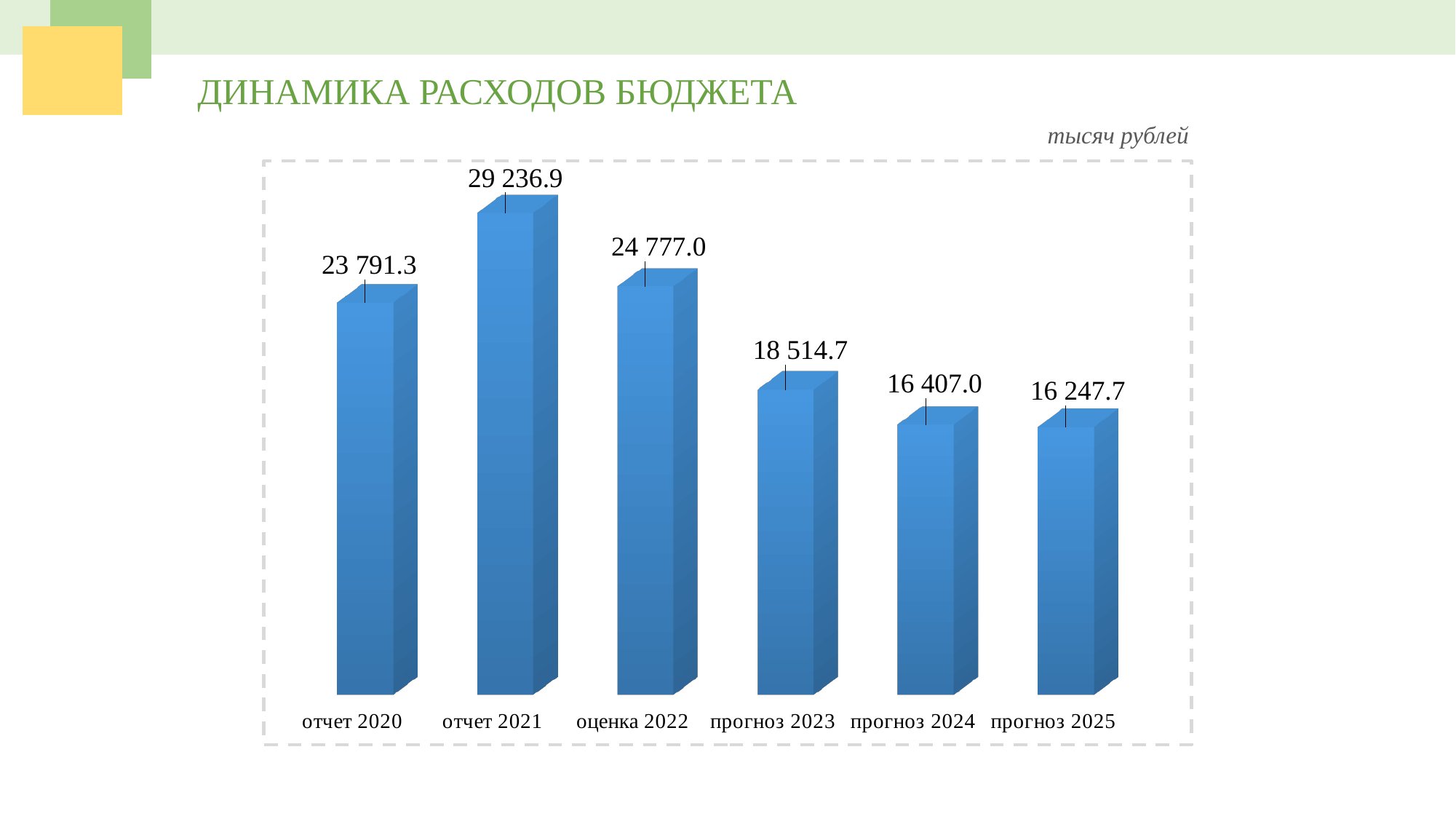
What is the difference between the values for отчет 2021 and отчет 2020? 5 445.6 What is the value for прогноз 2024? 16 407.0 Which category has the lowest value? прогноз 2025 Do the values rise or fall from оценка 2022 to прогноз 2025? fall What is the difference between the values for прогноз 2024 and прогноз 2025? 159.3 Which is larger, the value for отчет 2020 or the value for оценка 2022? оценка 2022 Which category has the highest value? отчет 2021 What is the title of the chart? ДИНАМИКА РАСХОДОВ БЮДЖЕТА What is the value for оценка 2022? 24 777.0 What kind of chart is shown on the slide? bar chart How many categories are shown on the chart? 6 What is the value for отчет 2021? 29 236.9